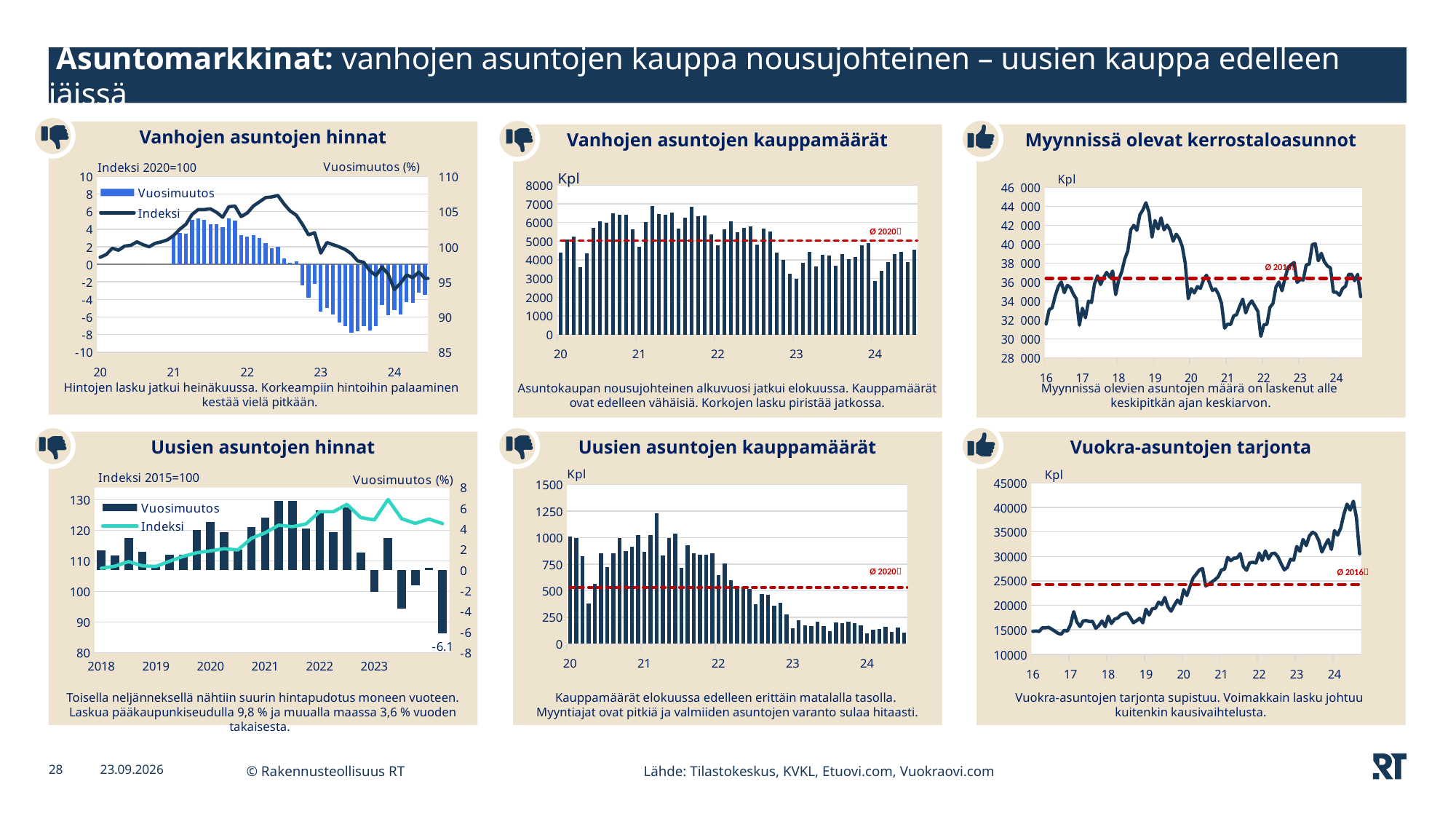
In 'Vanhojen asuntojen hinnat', is the Indeksi line higher in 2022 or in 2024? 2022 In 'Uusien asuntojen kauppamäärät', do the bars rise or fall from 2021 to 2024? fall In 'Uusien asuntojen hinnat', what value is printed on the last Vuosimuutos bar? -6.1 In 'Vuokra-asuntojen tarjonta', is the value at the start of 2016 greater or less than 20000? less In 'Uusien asuntojen kauppamäärät', are the bars in 2024 greater or less than 250? less What kind of chart is 'Vanhojen asuntojen kauppamäärät'? bar chart In 'Myynnissä olevat kerrostaloasunnot', is the peak value around 2019 greater or less than 42 000? greater In 'Vuokra-asuntojen tarjonta', does the line overall rise or fall from 2016 to 2024? rise How many series does the legend of 'Vanhojen asuntojen hinnat' list? 2 What label is printed on the red dashed line in 'Vanhojen asuntojen kauppamäärät'? Ø 2020 What kind of chart is 'Vuokra-asuntojen tarjonta'? line chart